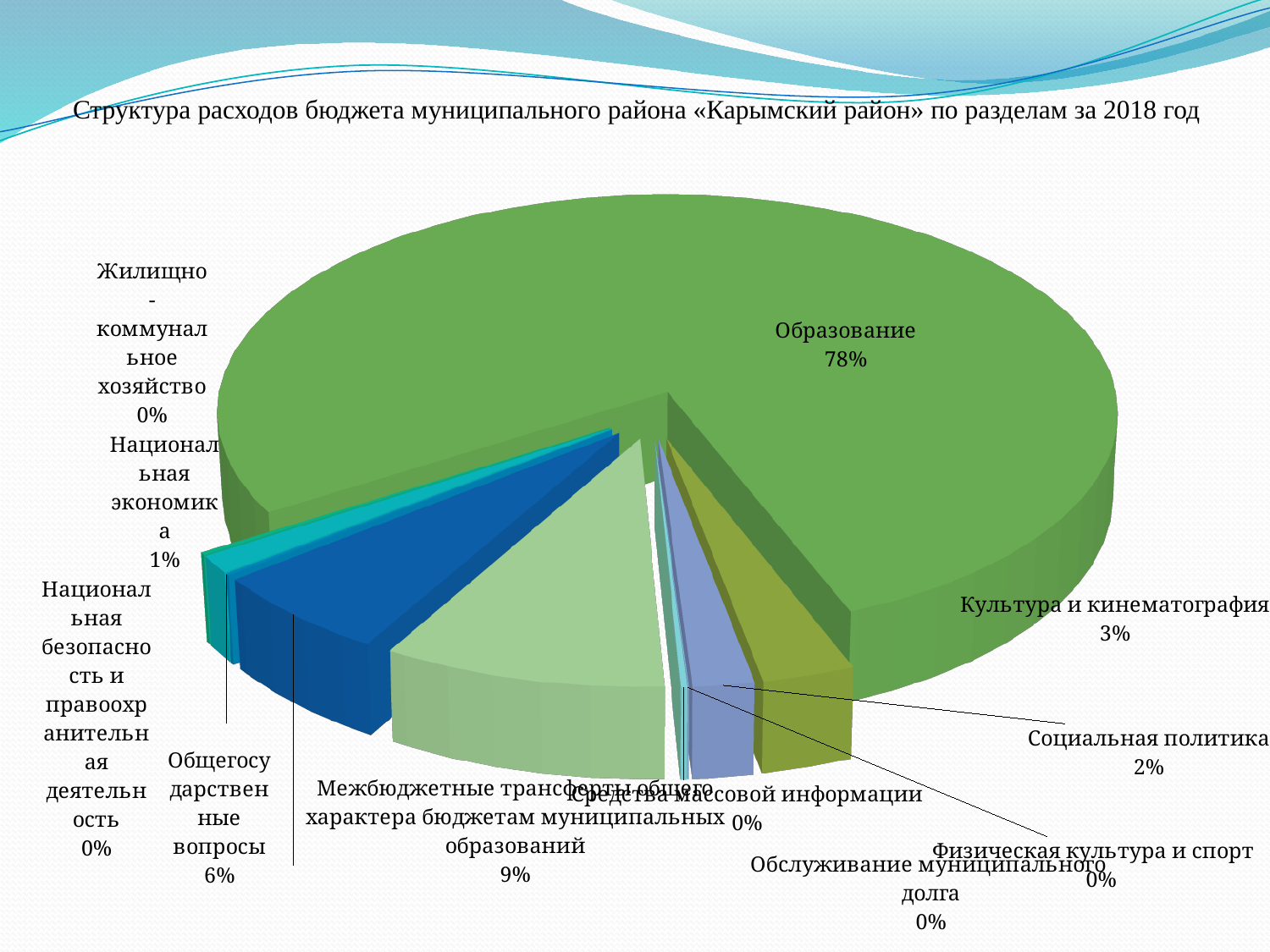
What is the difference in percentage points between Образование and Межбюджетные трансферты общего характера бюджетам муниципальных образований? 69 What percentage is shown for Межбюджетные трансферты общего характера бюджетам муниципальных образований? 9% What percentage is shown for Социальная политика? 2% What share of the budget expenditure goes to Образование? 78% What percentage is shown for Общегосударственные вопросы? 6% How many sections (categories) are labelled in the pie chart? 11 Which section has the largest share of the budget expenditure? Образование Which is larger: the share for Общегосударственные вопросы or the share for Культура и кинематография? Общегосударственные вопросы What is the title of the chart? Структура расходов бюджета муниципального района «Карымский район» по разделам за 2018 год What kind of chart is shown on the slide? pie chart What percentage is shown for Культура и кинематография? 3% What percentage is shown for Национальная экономика? 1%